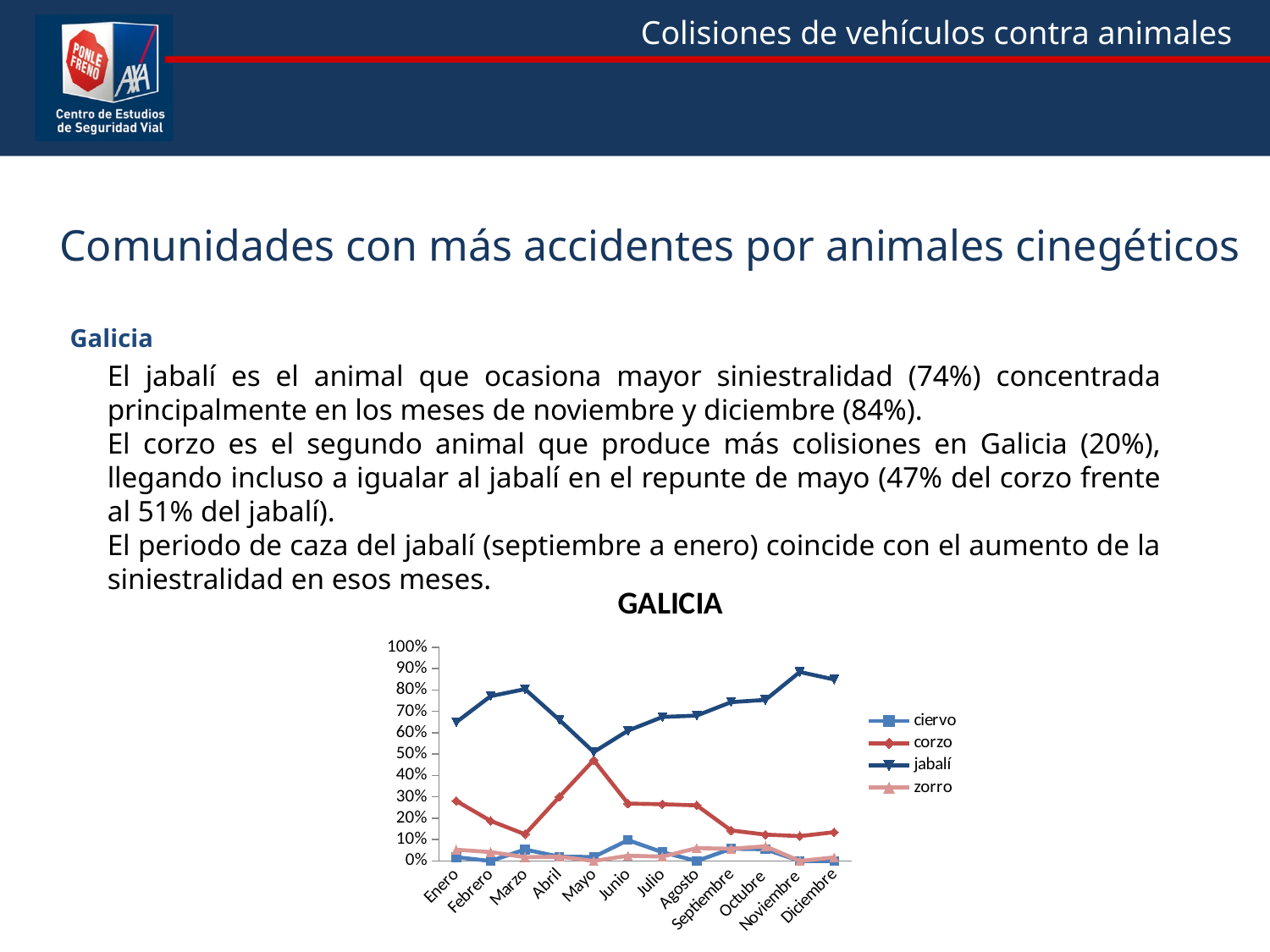
In Enero, which is larger: the value for corzo or the value for ciervo? corzo Which series has the highest value in Noviembre? jabalí In which month does the corzo series reach its highest value? Mayo Does the corzo line rise or fall from Mayo to Septiembre? fall How many months are shown on the x axis of the GALICIA chart? 12 What is the title of the chart? GALICIA Does the jabalí line rise or fall from Septiembre to Noviembre? rise How many series does the legend of the GALICIA chart list? 4 What kind of chart is shown on the slide? line chart Is the value for jabalí in Mayo greater or less than 60%? less Is the value for jabalí in Noviembre greater or less than 80%? greater Is the value for corzo in Mayo greater or less than 40%? greater